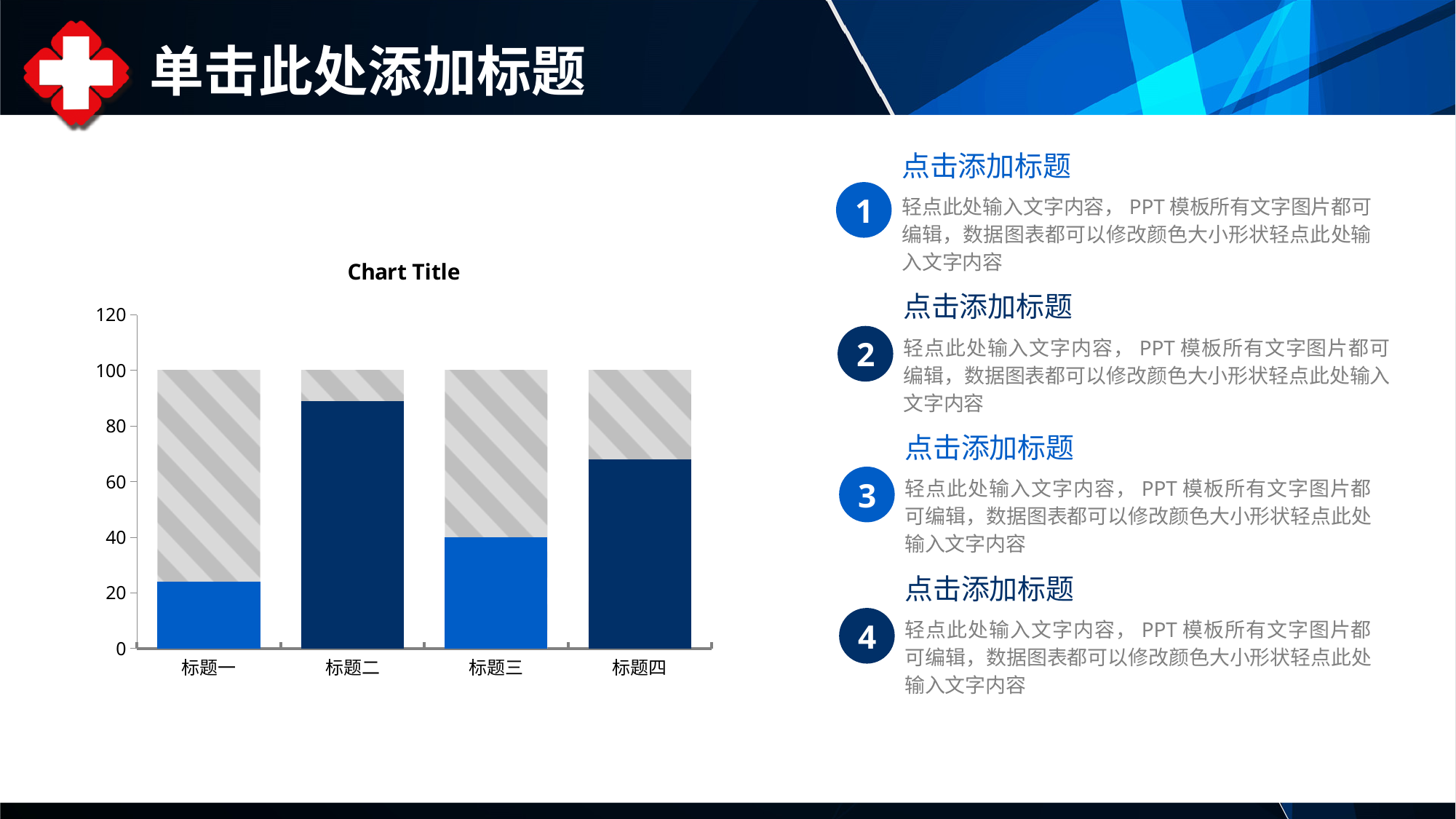
Is the blue (bottom) segment for 标题二 greater or less than 80? greater What is the title of the chart? Chart Title How many categories are shown on the x axis of the chart? 4 Which has the larger blue (bottom) segment, 标题三 or 标题四? 标题四 Is the blue (bottom) segment for 标题一 greater or less than 40? less What is the highest value shown on the y axis of the chart? 120 Is the blue (bottom) segment for 标题四 greater or less than 60? greater What kind of chart is shown on the slide? bar chart Which category has the tallest blue (bottom) segment? 标题二 What is the total height of the stacked bar for 标题一? 100 Which category has the shortest blue (bottom) segment? 标题一 What is the value of the blue (bottom) segment for 标题三? 40